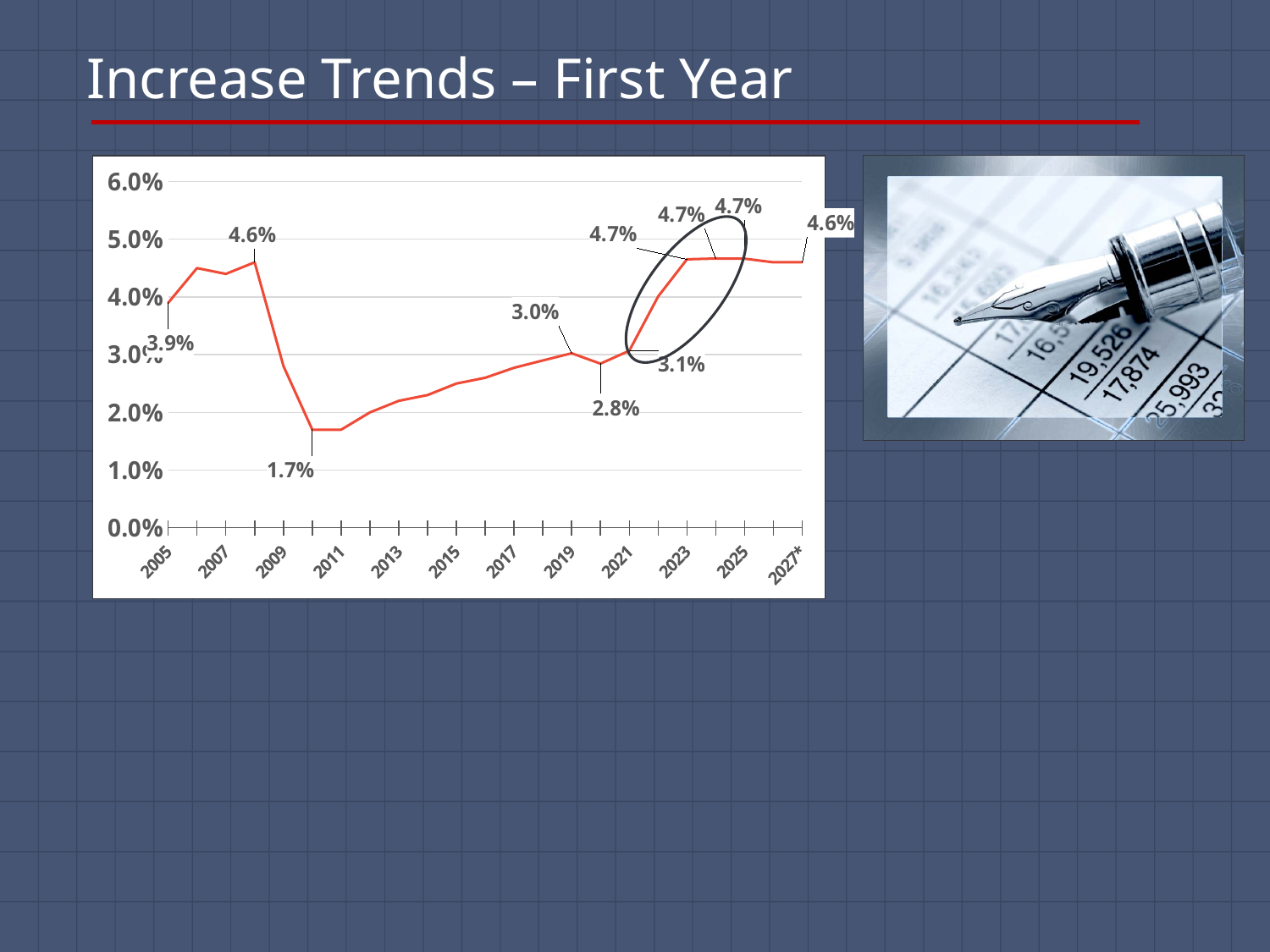
What is the value for 2021? 3.1% Which year has the lowest value? 2010 and 2011 (tied at 1.7%) What is the difference between the 2005 value and the 2010 value? 2.2 percentage points Do the values rise or fall between 2010 and 2019? rise What is the value for 2027*? 4.6% What kind of chart is shown on the slide? line chart What is the highest value labelled on the chart? 4.7% What is the value for 2020? 2.8% Is the value for 2015 greater or less than 3.0%? less What is the value for 2010? 1.7% Which is larger, the value for 2021 or the value for 2020? 2021 What is the value for 2005? 3.9%